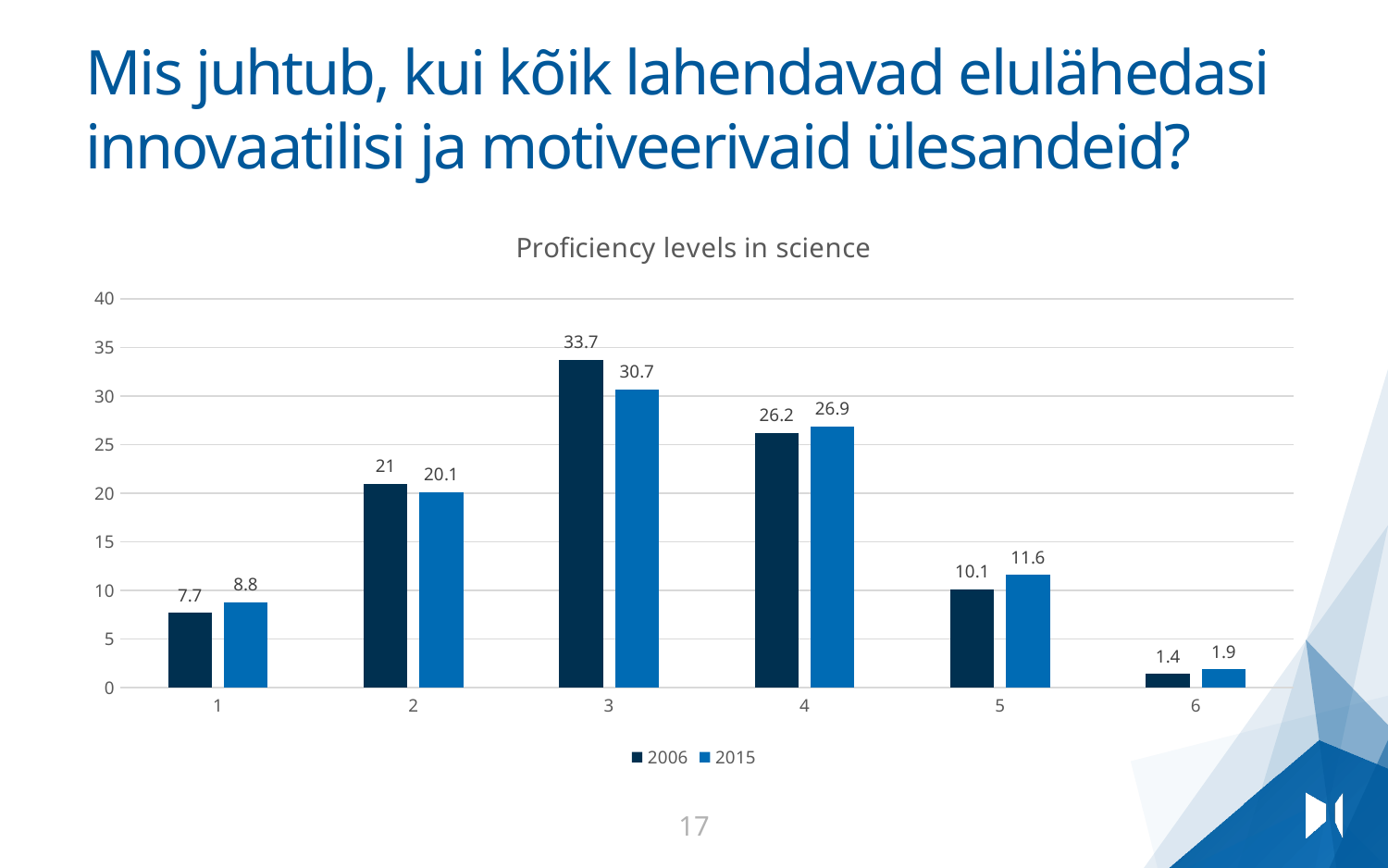
How many proficiency levels are shown on the x axis? 6 Which is larger for proficiency level 4: the 2006 value or the 2015 value? 2015 Is the 2015 value for proficiency level 2 greater or less than 25? less What is the difference between the 2015 and 2006 values for proficiency level 5? 1.5 What is the difference between the 2006 and 2015 values for proficiency level 3? 3 Which proficiency level has the highest value in the 2015 series? 3 What is the value for proficiency level 3 in the 2006 series? 33.7 What is the value for proficiency level 2 in the 2006 series? 21 Which proficiency level has the lowest value in the 2006 series? 6 What type of chart is shown on the slide? bar chart How many series does the legend list? 2 What is the value for proficiency level 5 in the 2015 series? 11.6